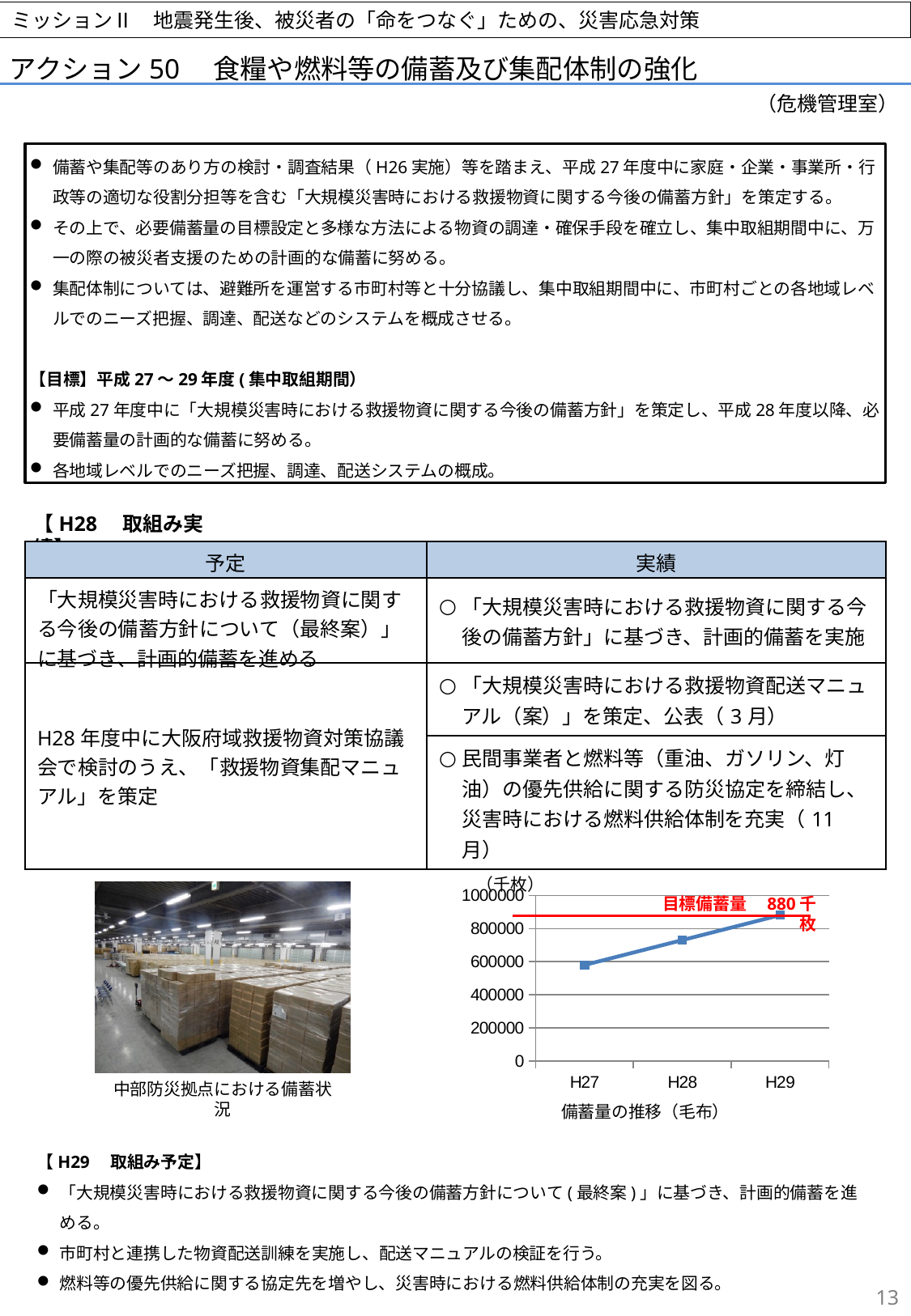
Do the values rise or fall from H27 to H29? rise Is the value for H28 greater or less than 600000? greater How many data points are plotted on the chart? 3 Is the value for H27 greater or less than 400000? greater Which year has the lowest stockpile value on the chart? H27 Which year has the highest stockpile value on the chart? H29 Is the value for H28 greater or less than 800000? less Which is larger, the value for H28 or the value for H27? H28 What target stockpile amount (目標備蓄量) is labelled on the red line in the chart? 880千枚 What is the title of the chart? 備蓄量の推移（毛布） What kind of chart is shown on the slide? line chart